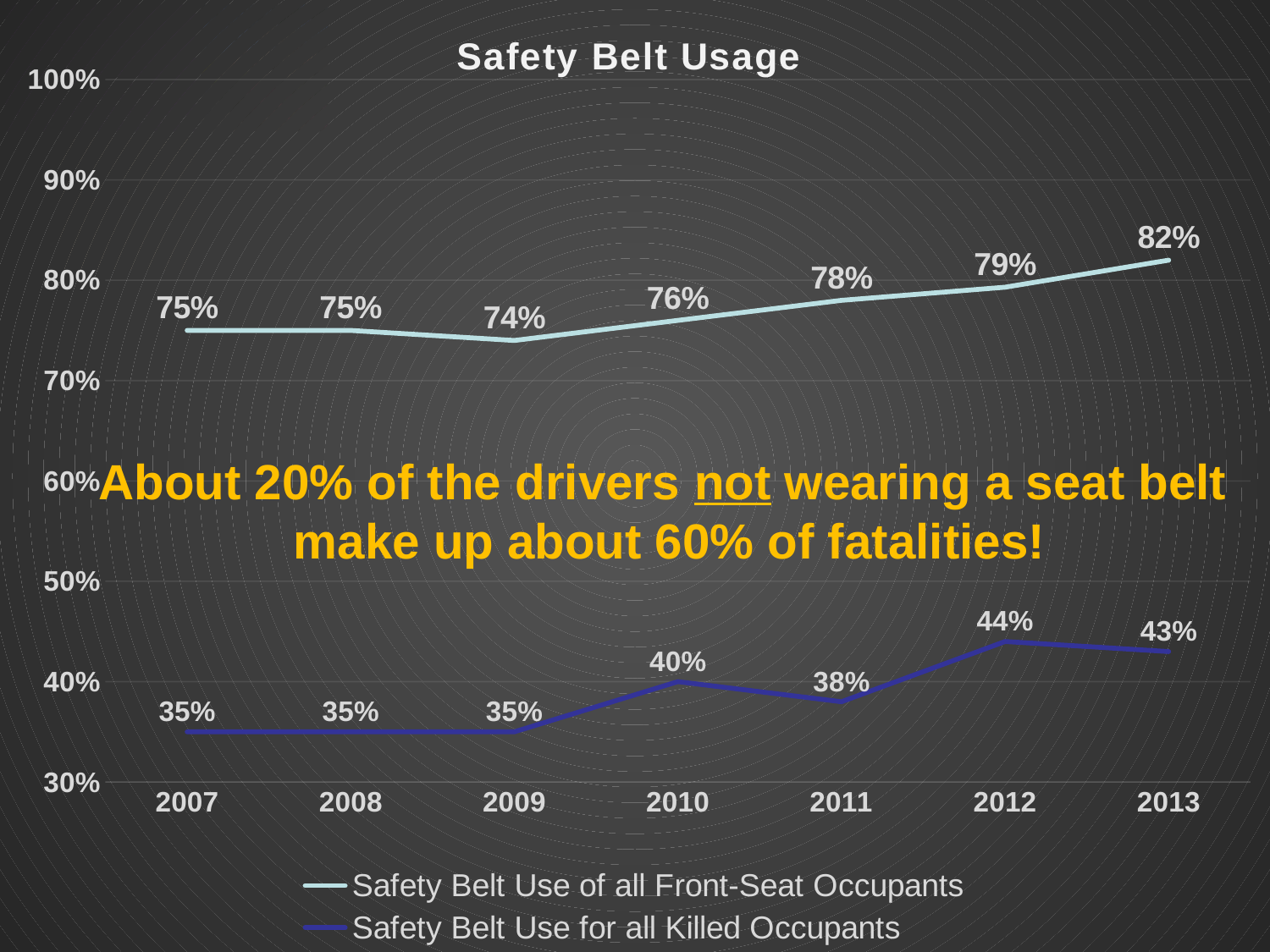
Which is larger: Safety Belt Use for all Killed Occupants in 2011 or in 2012? 2012 Is the Safety Belt Use of all Front-Seat Occupants in 2012 greater or less than 70%? greater What is the Safety Belt Use of all Front-Seat Occupants in 2013? 82% How many series does the legend list? 2 What is the Safety Belt Use of all Front-Seat Occupants in 2009? 74% In which year is the Safety Belt Use for all Killed Occupants highest? 2012 What is the Safety Belt Use for all Killed Occupants in 2010? 40% What is the title of the chart? Safety Belt Usage In which year is the Safety Belt Use of all Front-Seat Occupants lowest? 2009 What is the difference between Safety Belt Use of all Front-Seat Occupants and Safety Belt Use for all Killed Occupants in 2013? 39% How many years are shown on the x axis? 7 What kind of chart is shown? Line chart